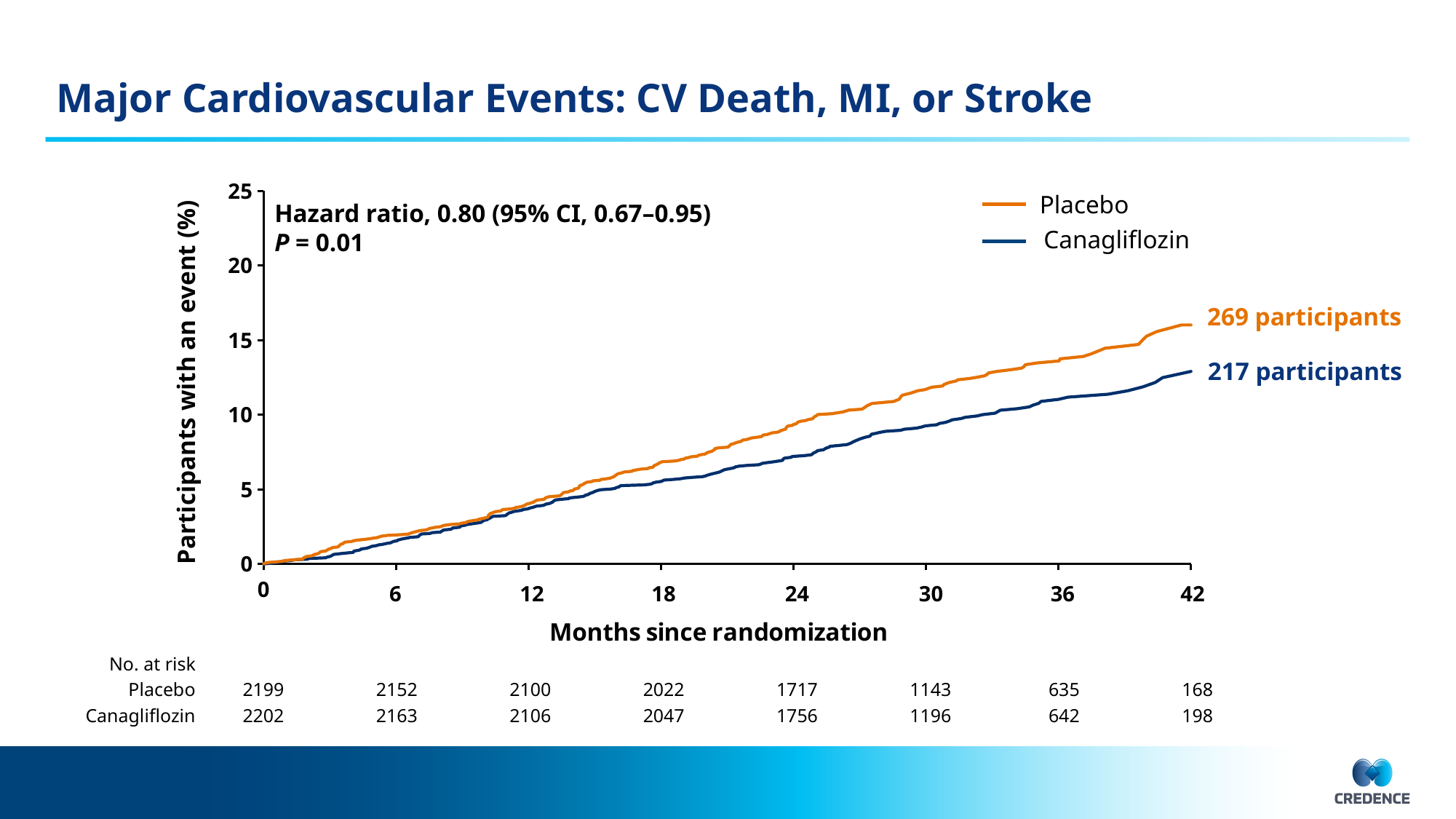
How many series does the legend list? 2 According to the No. at risk table, how many Canagliflozin participants were at risk at 0 months? 2202 Is the value for Canagliflozin at 42 months greater or less than 15? less What is the difference between the number of participants with an event in the Placebo group and the Canagliflozin group? 52 How many participants with an event are labelled at the end of the Placebo curve? 269 participants What kind of chart is shown on the slide? Line chart Which group has the higher percentage of participants with an event at 42 months, Placebo or Canagliflozin? Placebo How many participants with an event are labelled at the end of the Canagliflozin curve? 217 participants Do the curves rise or fall as months since randomization increase? Rise What hazard ratio is printed on the chart? 0.80 (95% CI, 0.67–0.95) Is the value for Placebo at 24 months greater or less than 10? less According to the No. at risk table, how many Placebo participants were at risk at 42 months? 168